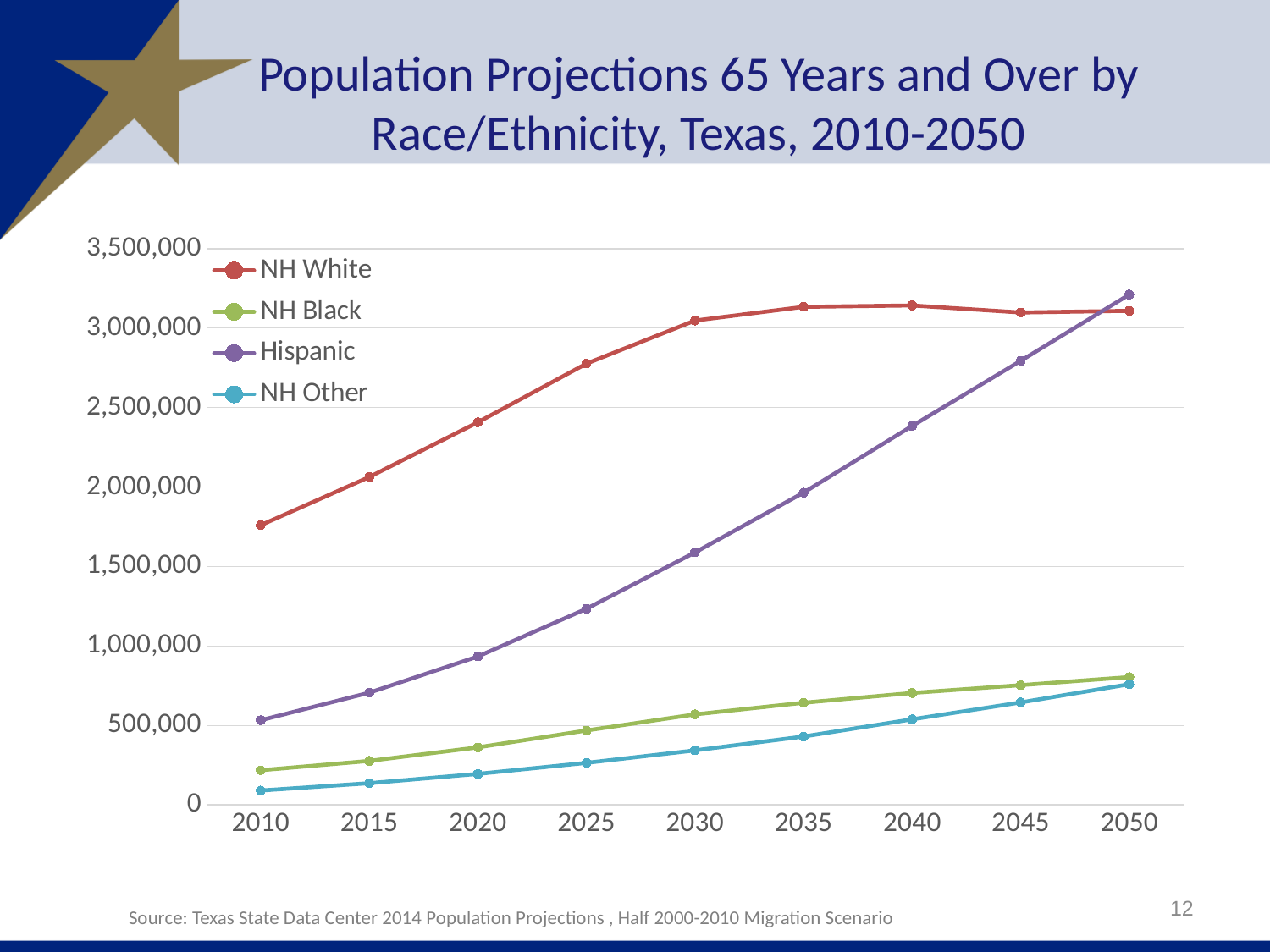
Is the value for NH White in 2010 greater or less than 1,500,000? greater What kind of chart is shown on the slide? Line chart Is the value for NH Black in 2050 greater or less than 1,000,000? less Which series has the lowest value in 2010? NH Other Is the value for Hispanic in 2040 greater or less than 2,500,000? less In 2040, which is larger: NH White or Hispanic? NH White In 2030, which is larger: NH Black or NH Other? NH Black How many years are plotted along the x axis? 9 What is the title of the chart? Population Projections 65 Years and Over by Race/Ethnicity, Texas, 2010-2050 Which series has the highest value in 2030? NH White Does the Hispanic series rise or fall from 2010 to 2050? Rise How many series does the legend list? 4